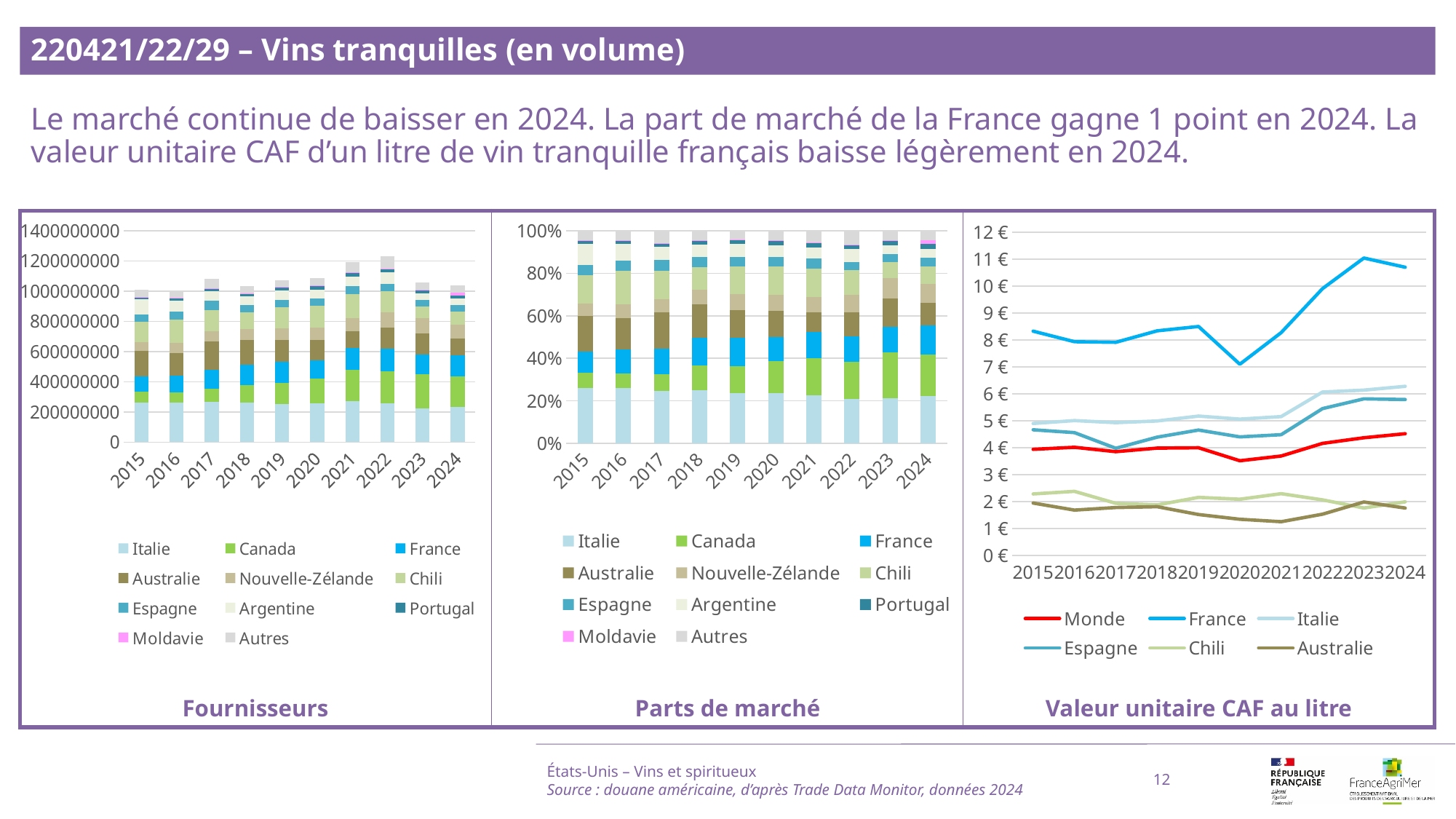
What kind of chart is the 'Fournisseurs' chart? bar chart In the 'Valeur unitaire CAF au litre' chart, is the value for France in 2023 greater or less than 10 €? greater In the 'Fournisseurs' chart, which year has the highest total bar? 2022 What kind of chart is the 'Valeur unitaire CAF au litre' chart? line chart In the 'Valeur unitaire CAF au litre' chart, does the France line rise or fall between 2020 and 2023? rise In the 'Valeur unitaire CAF au litre' chart, what colour is the 'Monde' line? red In the 'Valeur unitaire CAF au litre' chart, is the value for France in 2020 greater or less than 8 €? less How many series does the legend of the 'Fournisseurs' chart list? 11 How many series does the legend of the 'Valeur unitaire CAF au litre' chart list? 6 How many years are shown on the x axis of the 'Parts de marché' chart? 10 In the 'Valeur unitaire CAF au litre' chart, which series has the highest values across all years? France In the 'Fournisseurs' chart, is the total for 2024 greater or less than 1200000000? less